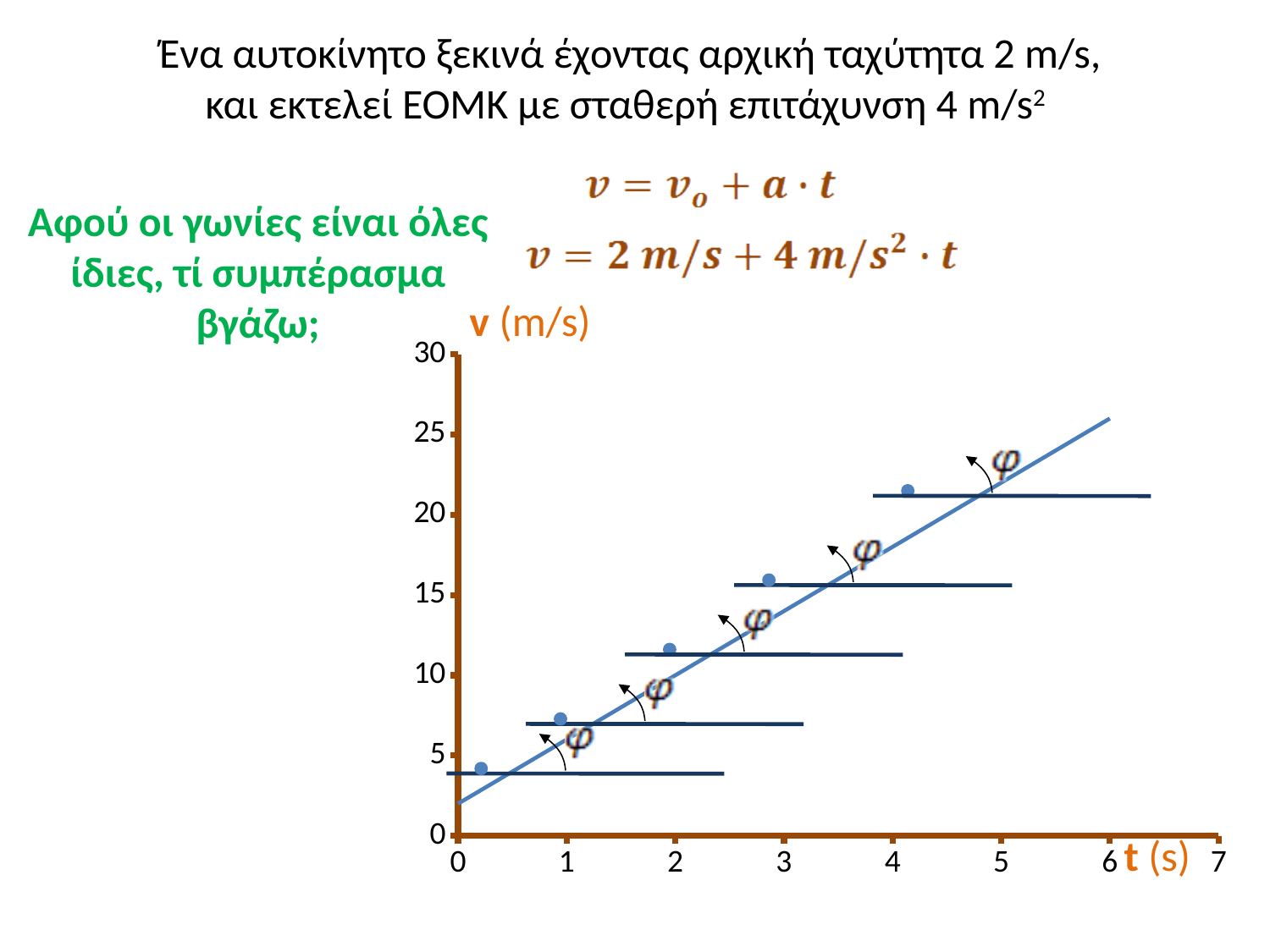
Is the value of v on the line at t = 5 s greater or less than 20? greater Is the value of v on the line at t = 0 s greater or less than 5? less Is the value of v on the line at t = 3 s greater or less than 20? less How many blue dots are marked along the line on the chart? 5 What is the label of the horizontal axis of the chart? t (s) Does the plotted line rise or fall as t increases? rises What is the label of the vertical axis of the chart? v (m/s) What kind of chart is shown on the slide? line chart